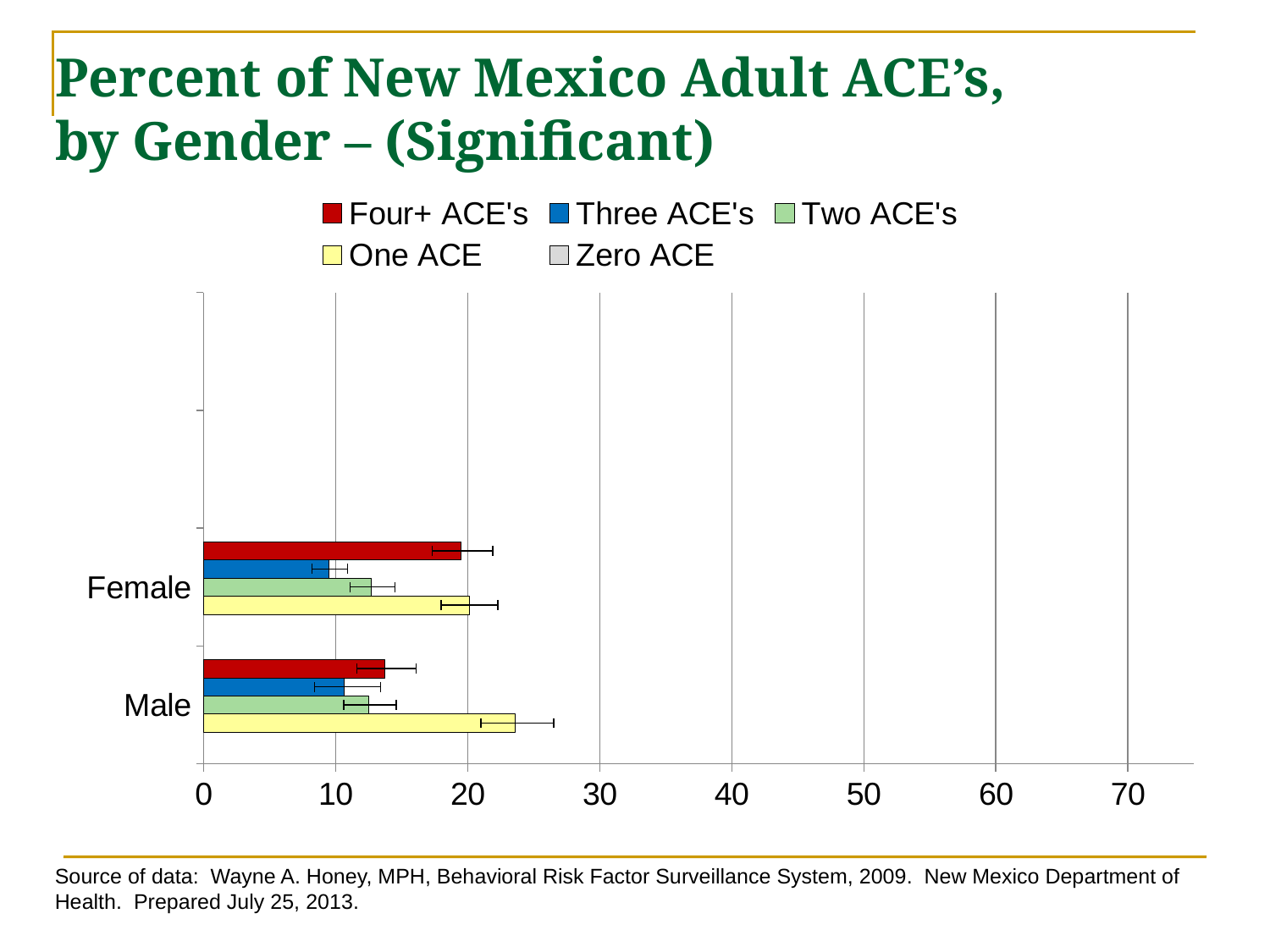
What kind of chart is shown on the slide? bar chart Among the Male bars, which series has the highest value? One ACE Which is larger, the One ACE value for Males or the One ACE value for Females? Males Is the value for Four+ ACE's among Males greater or less than 20? less Is the value for Two ACE's among Females greater or less than 20? less Among the Female bars, which series has the lowest value? Three ACE's How many series does the legend list? 5 Is the value for One ACE among Males greater or less than 20? greater Which is larger, the Four+ ACE's value for Females or the Four+ ACE's value for Males? Females What is the highest value shown on the horizontal axis? 70 How many gender categories are labelled on the vertical axis? 2